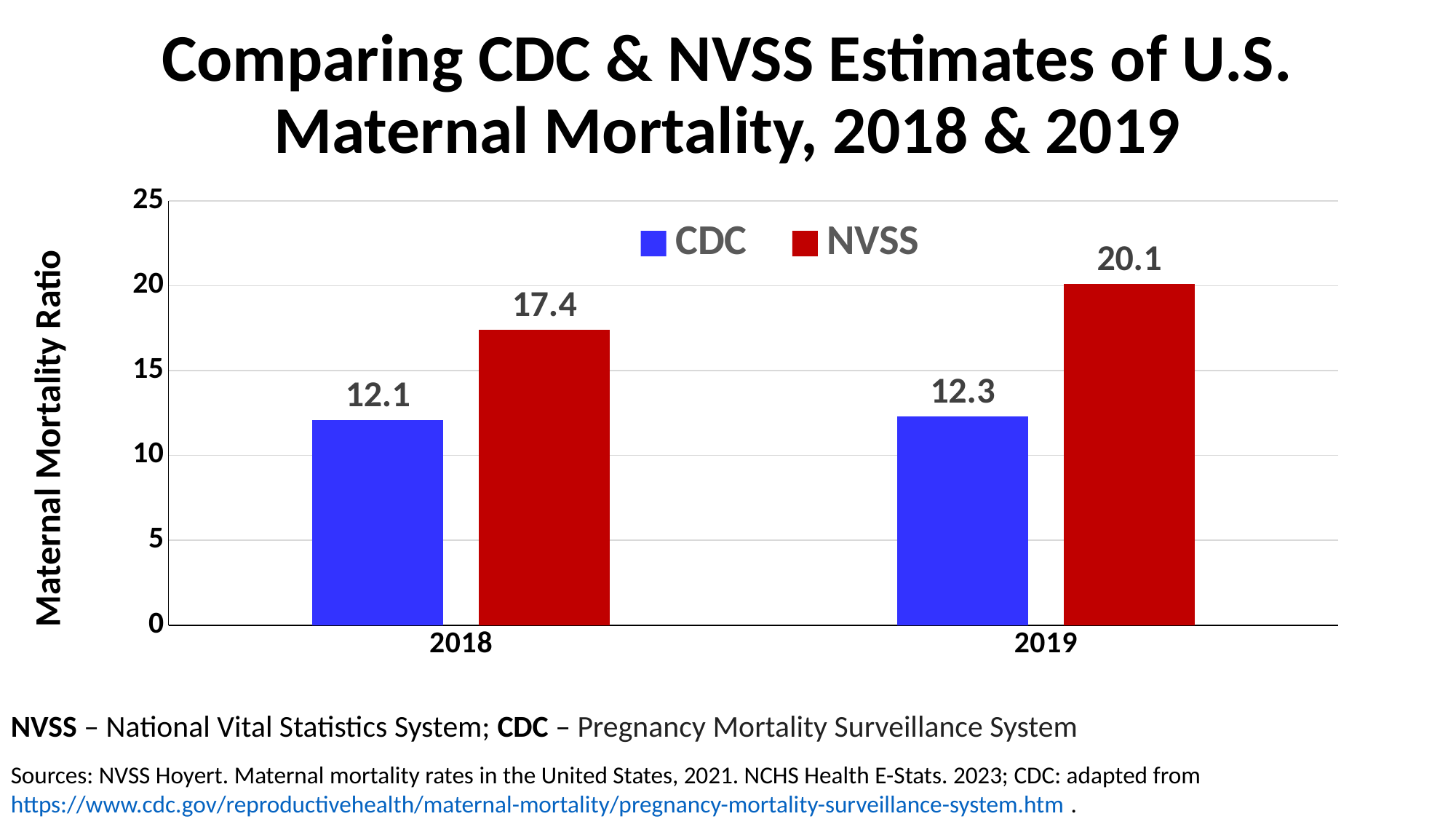
What kind of chart is shown on the slide? Bar chart How many series does the legend list? 2 What is the CDC maternal mortality ratio for 2018? 12.1 Which series has the lowest value in 2018? CDC What is the NVSS maternal mortality ratio for 2019? 20.1 Does the NVSS maternal mortality ratio rise or fall from 2018 to 2019? Rise What is the NVSS value for 2018? 17.4 What is the CDC value for 2019? 12.3 What is the difference between the NVSS and CDC estimates for 2018? 5.3 Which year has the highest NVSS maternal mortality ratio? 2019 Which is larger in 2018, the CDC estimate or the NVSS estimate? NVSS What is the difference between the NVSS and CDC estimates for 2019? 7.8